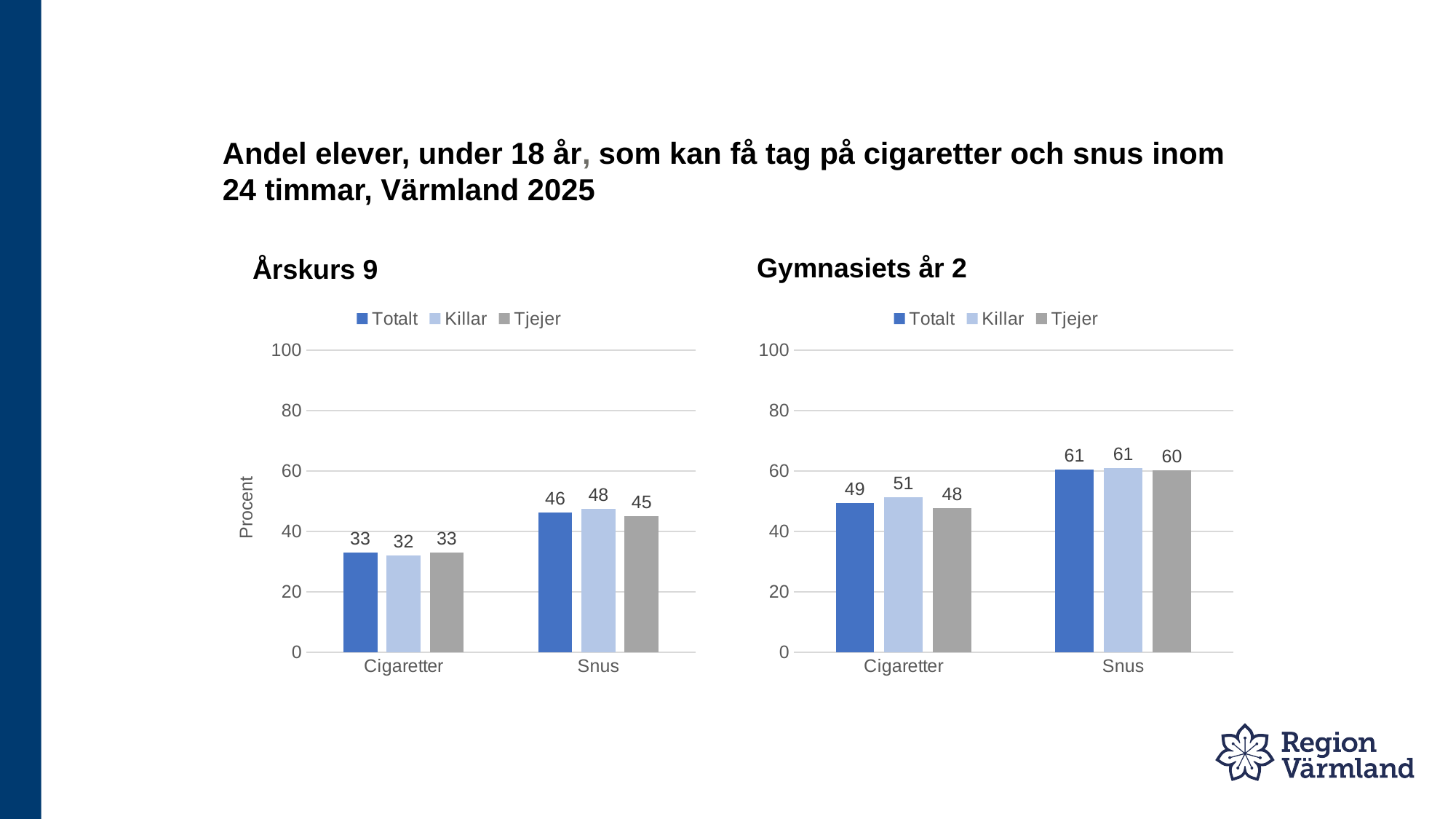
Which is larger: the Totalt value for Snus in the Årskurs 9 chart or the Totalt value for Snus in the Gymnasiets år 2 chart? Gymnasiets år 2 In the Årskurs 9 chart, which series has the lowest value for Snus? Tjejer What kind of chart is the Gymnasiets år 2 chart? Bar chart How many series does the legend of the Årskurs 9 chart list? 3 In the Gymnasiets år 2 chart, what is the difference between the Killar values for Snus and Cigaretter? 10 In the Årskurs 9 chart, what is the value for Killar for Snus? 48 In the Gymnasiets år 2 chart, what is the value for Tjejer for Cigaretter? 48 In the Årskurs 9 chart, what is the difference between the Totalt values for Snus and Cigaretter? 13 In the Gymnasiets år 2 chart, what is the value for Totalt for Snus? 61 In the Gymnasiets år 2 chart, which series has the highest value for Cigaretter? Killar In the Årskurs 9 chart, what is the value for Totalt for Cigaretter? 33 How many categories are shown on the x axis of the Gymnasiets år 2 chart? 2